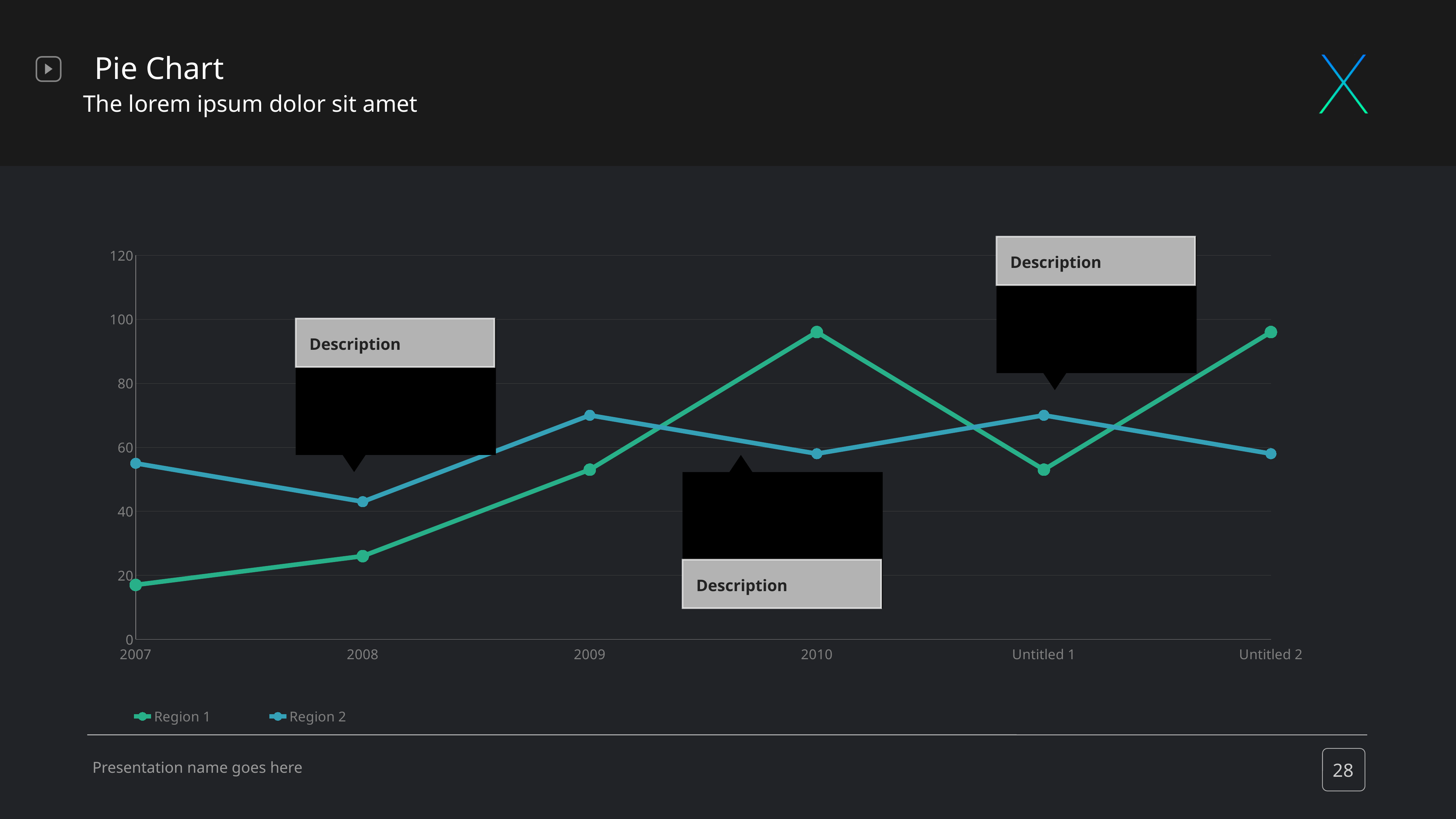
In 2007, which series has the larger value, Region 1 or Region 2? Region 2 What kind of chart is shown on the slide? line chart Which category has the lowest value for Region 2? 2008 Does the Region 1 line rise or fall from 2007 to 2010? rise How many categories are shown on the x axis? 6 Is the value for Region 2 in 2008 greater or less than 60? less In 2010, which series has the larger value, Region 1 or Region 2? Region 1 How many series does the legend list? 2 Is the value for Region 1 in 2007 greater or less than 20? less Is the value for Region 2 in 2009 greater or less than 60? greater Which category has the lowest value for Region 1? 2007